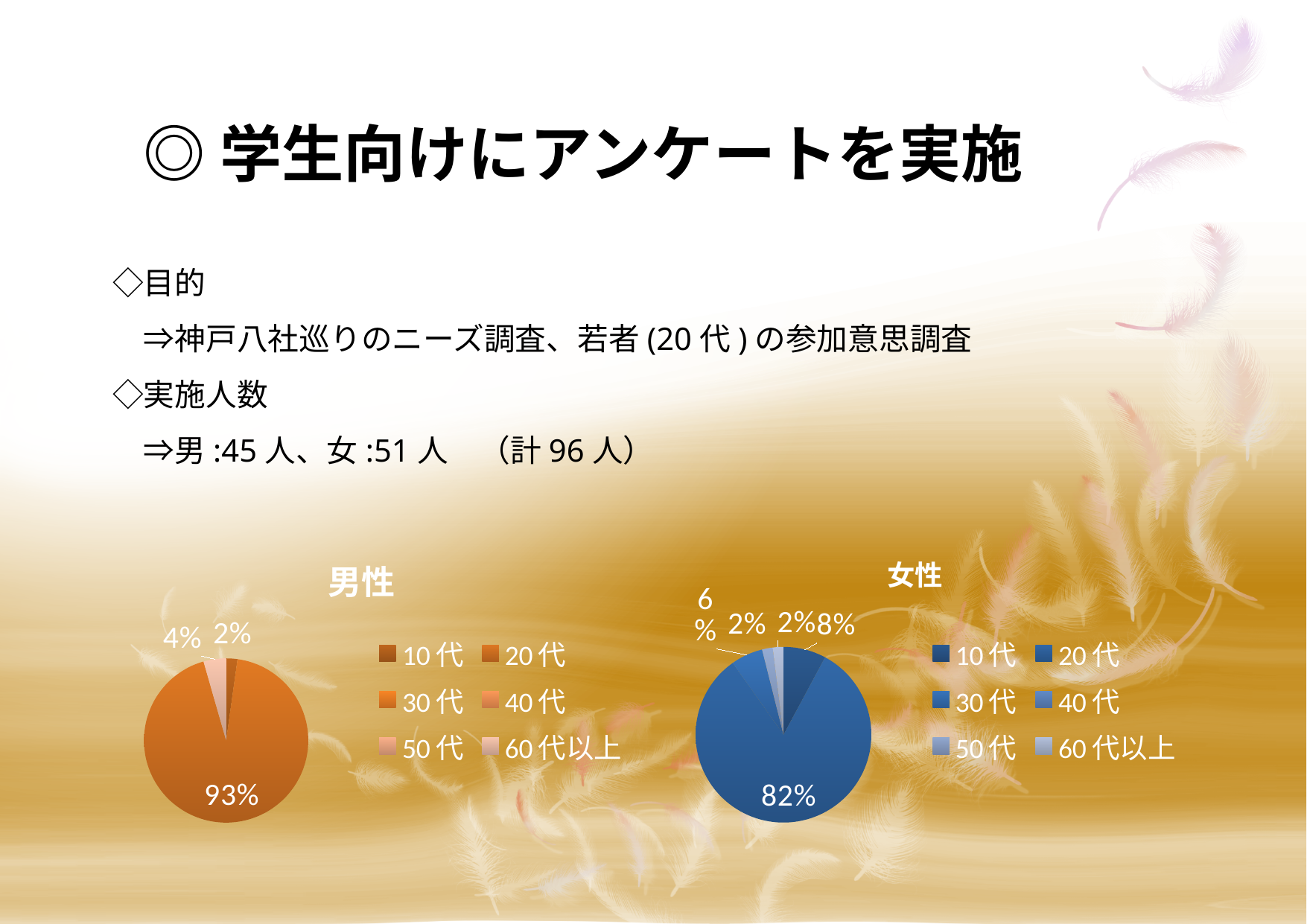
How many data labels are shown on the 男性 pie chart? 3 In the 女性 pie chart, what is the share of the largest slice? 82% In the 男性 pie chart, what is the share of the largest slice? 93% Which is larger: the largest slice in the 男性 pie chart or the largest slice in the 女性 pie chart? 男性 (93%) How many data labels are shown on the 女性 pie chart? 5 In the 男性 pie chart, which age group has the largest slice? 20代 What kind of charts are shown on the slide? Pie charts How many pie charts are on the slide? 2 In the 女性 pie chart, which age group has the largest slice? 20代 How many entries does the legend of the 男性 pie chart list? 6 What is the difference in percentage points between the largest slice of the 男性 pie chart (93%) and the largest slice of the 女性 pie chart (82%)? 11 percentage points What is the last legend entry listed for the 女性 pie chart? 60代以上